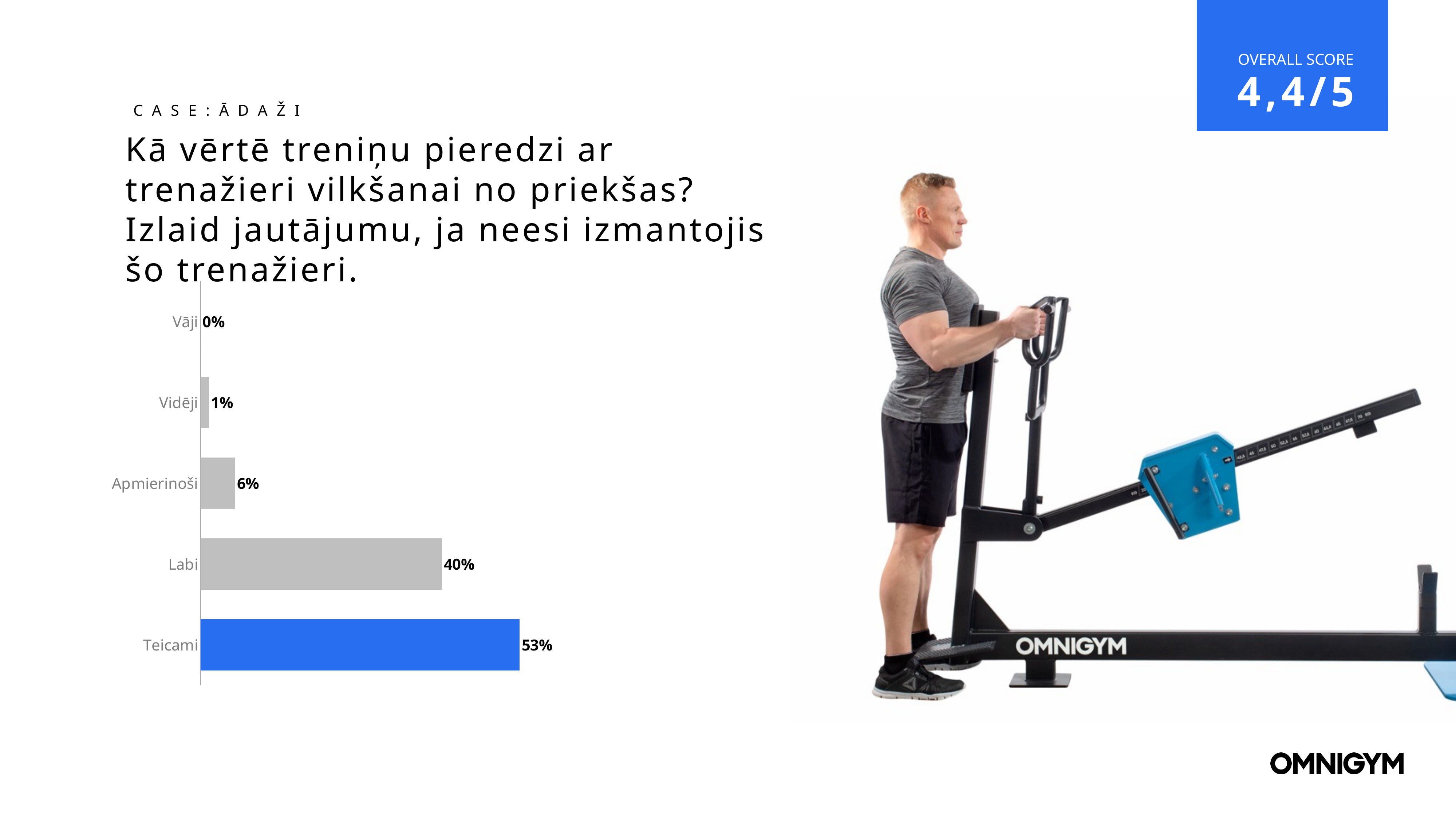
Which category has the highest value? Teicami Which bar is coloured blue rather than grey? Teicami Which category has the lowest value? Vāji What percentage of respondents rated the experience as Teicami? 53% What kind of chart is shown on the slide? Bar chart What is the value shown for Apmierinoši? 6% How many categories are shown in the chart? 5 What is the value shown for Vidēji? 1% What is the value shown for Vāji? 0% Which is larger, the value for Apmierinoši or the value for Vidēji? Apmierinoši What is the value shown for Labi? 40% What is the difference between the values for Teicami and Labi? 13%